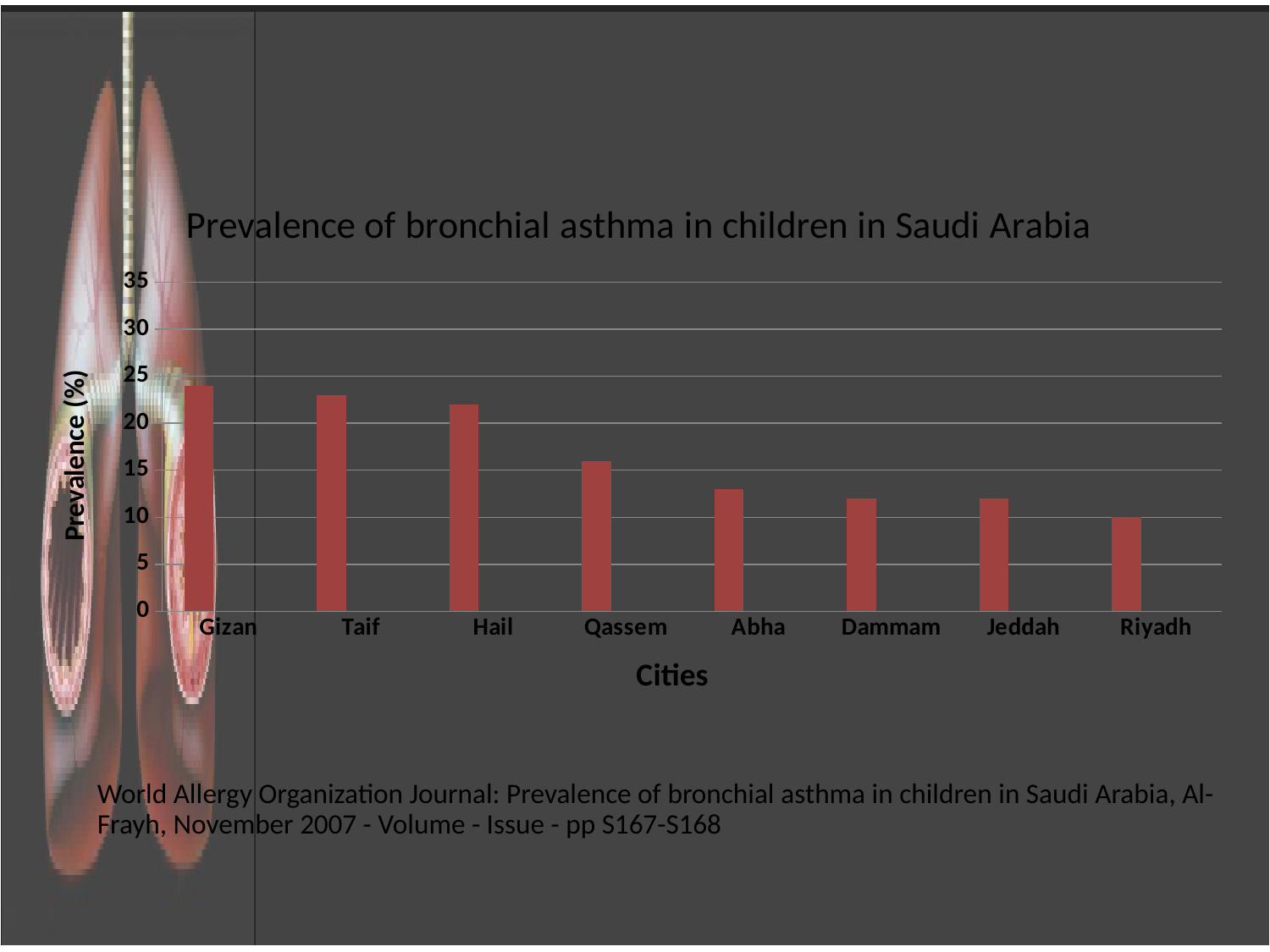
Which city has the lowest prevalence of bronchial asthma in the chart? Riyadh What is the title of the chart? Prevalence of bronchial asthma in children in Saudi Arabia What kind of chart is shown on the slide? bar chart Is the prevalence value for Hail greater or less than 20? greater Is the prevalence value for Qassem greater or less than 20? less Is the prevalence value for Gizan greater or less than 20? greater How many cities are shown on the x axis of the chart? 8 Which city has the highest prevalence of bronchial asthma in the chart? Gizan Which city has a higher prevalence, Taif or Qassem? Taif Do the prevalence values rise or fall moving from Gizan to Riyadh along the x axis? fall What is the label of the vertical axis of the chart? Prevalence (%)